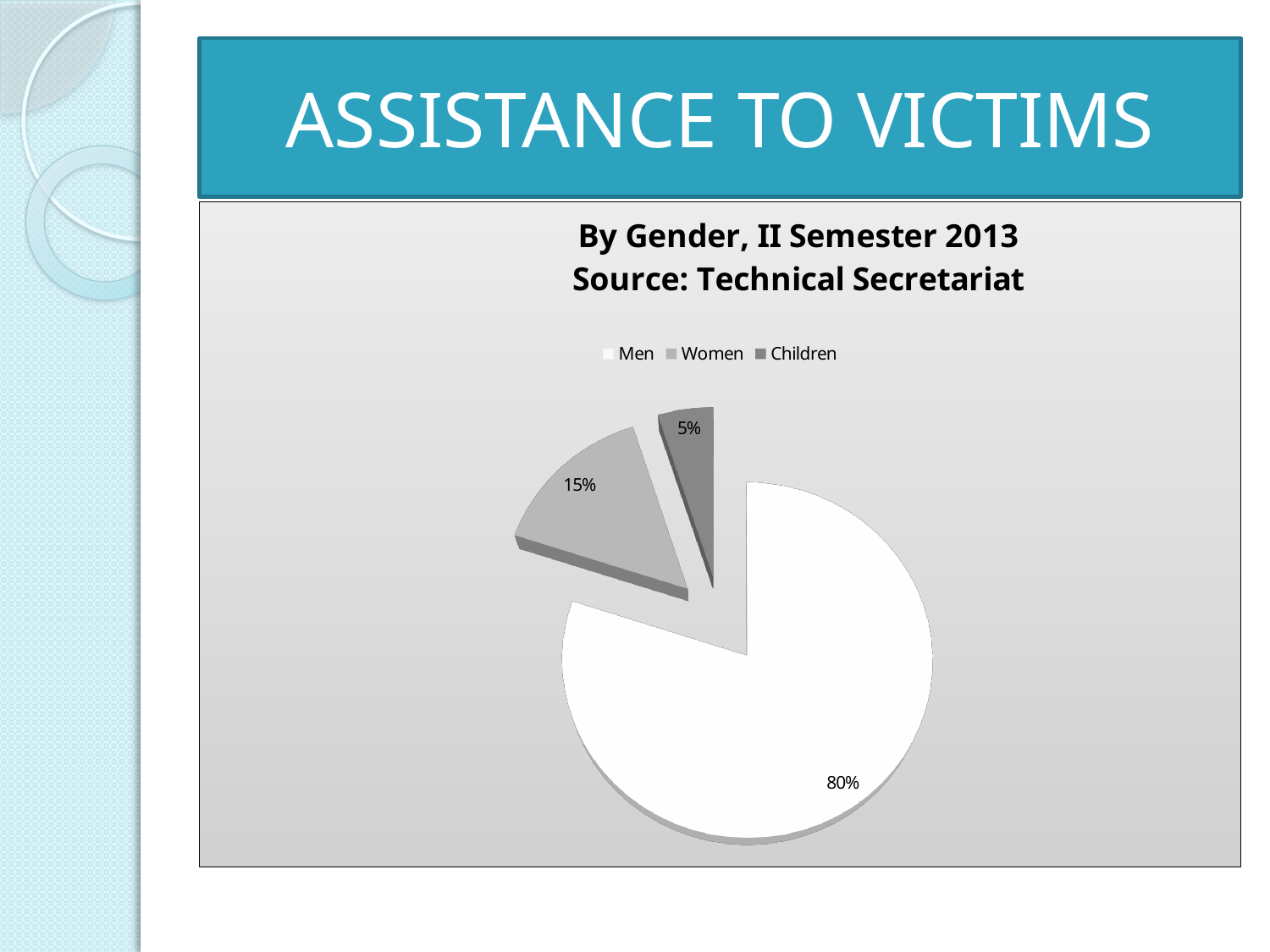
What share of the pie does Women account for? 15% Which category has the smallest slice of the pie? Children What share of the pie does Children account for? 5% Which category has the largest slice of the pie? Men Which slice is larger, Women or Children? Women How many slices does the pie chart have? 3 What is the title of the chart? By Gender, II Semester 2013 Source: Technical Secretariat How many entries does the legend list? 3 What is the difference in percentage points between the Women and Children slices? 10 What kind of chart is shown on the slide? Pie chart What share of the pie does Men account for? 80% What is the difference in percentage points between the Men and Women slices? 65